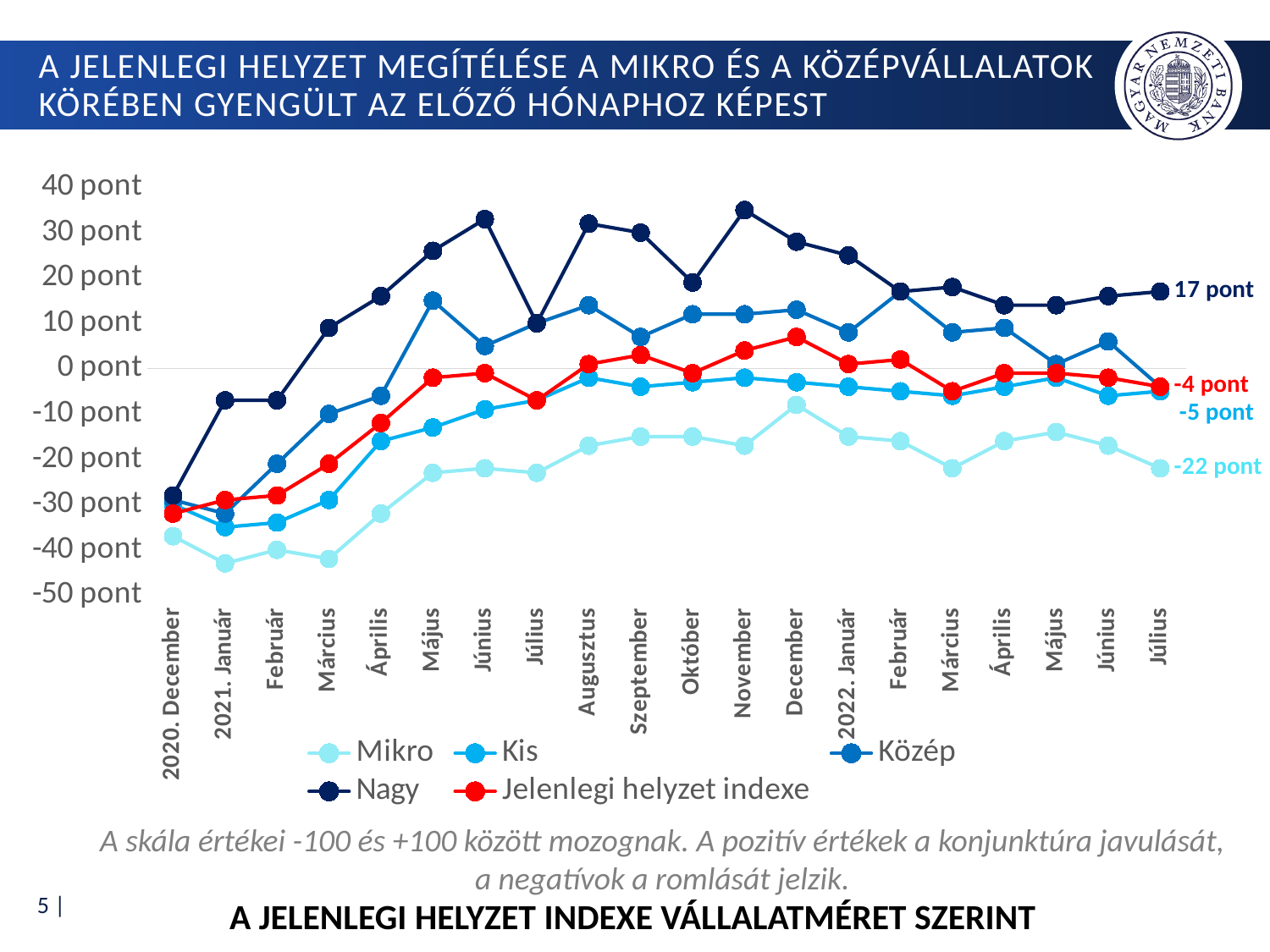
How many series does the legend list? 5 How many months (points) are shown along the x axis? 20 What is the value of the Kis series in 2022 Július? -5 pont What is the title of the chart shown at the bottom of the slide? A JELENLEGI HELYZET INDEXE VÁLLALATMÉRET SZERINT Is the value for Nagy in 2021 November greater or less than 30 pont? greater What is the value of the Mikro series in 2022 Július? -22 pont Is the value for Mikro in 2021 Január greater or less than -40 pont? less What is the value of the Jelenlegi helyzet indexe series in 2022 Július? -4 pont What kind of chart is shown on the slide? line chart What is the value of the Nagy series in 2022 Július? 17 pont What is the difference between the Nagy and Mikro values in 2022 Július? 39 pont Which series has the highest value in 2022 Július? Nagy